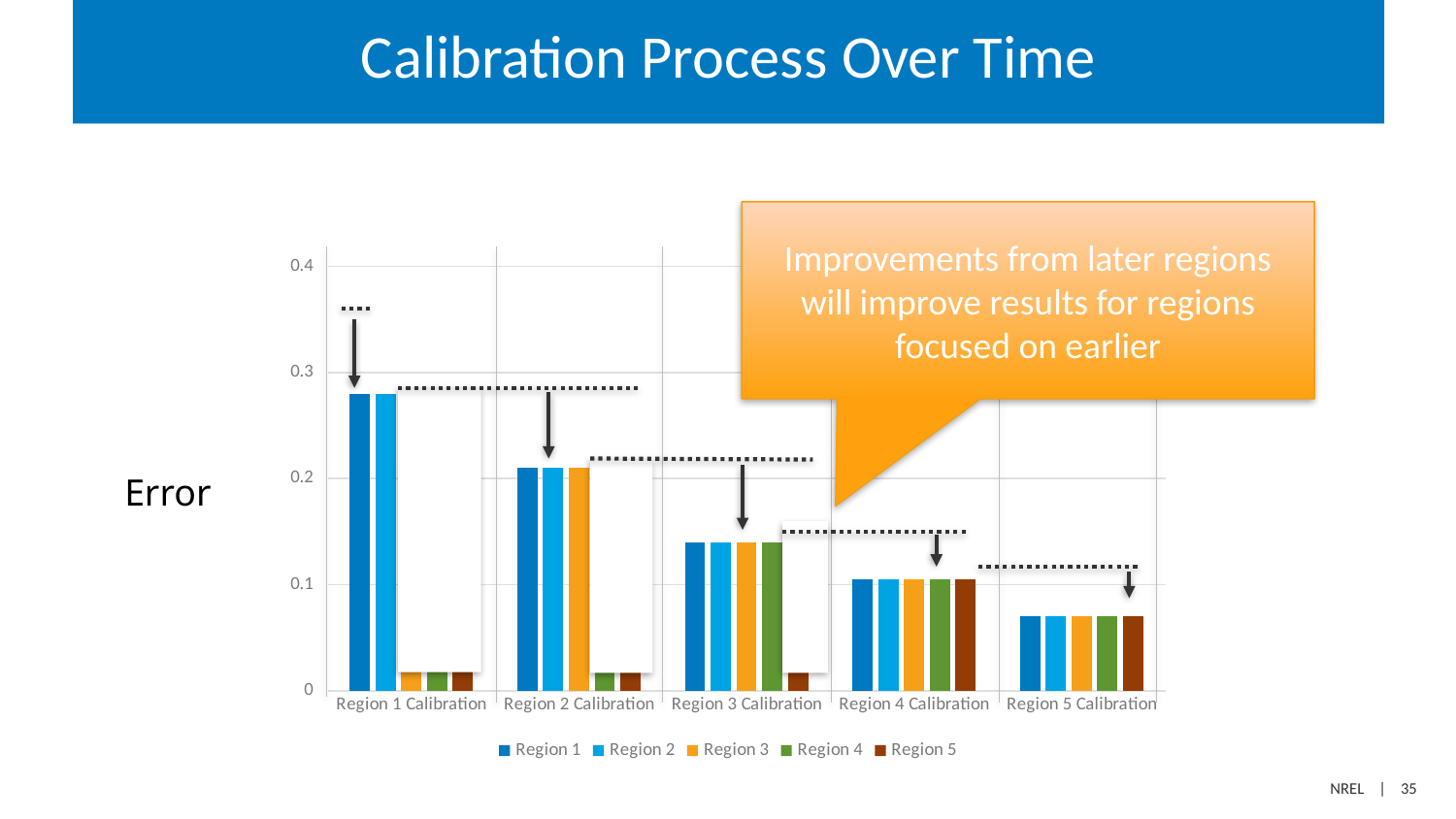
How many categories are shown along the x axis of the chart? 5 How many series does the chart's legend list? 5 Is the value for Region 5 in the Region 1 Calibration category greater or less than 0.1? less Do the values for the Region 1 series rise or fall from Region 1 Calibration to Region 5 Calibration? fall Is the value for Region 1 in the Region 1 Calibration category greater or less than 0.2? greater In which category does the Region 1 series have its lowest value? Region 5 Calibration Is the value for Region 3 in the Region 3 Calibration category greater or less than 0.2? less In the Region 1 Calibration category, which is larger: the value for Region 1 or the value for Region 5? Region 1 In which category does the Region 1 series reach its highest value? Region 1 Calibration What label is shown on the vertical axis of the chart? Error What kind of chart is shown on the slide? bar chart